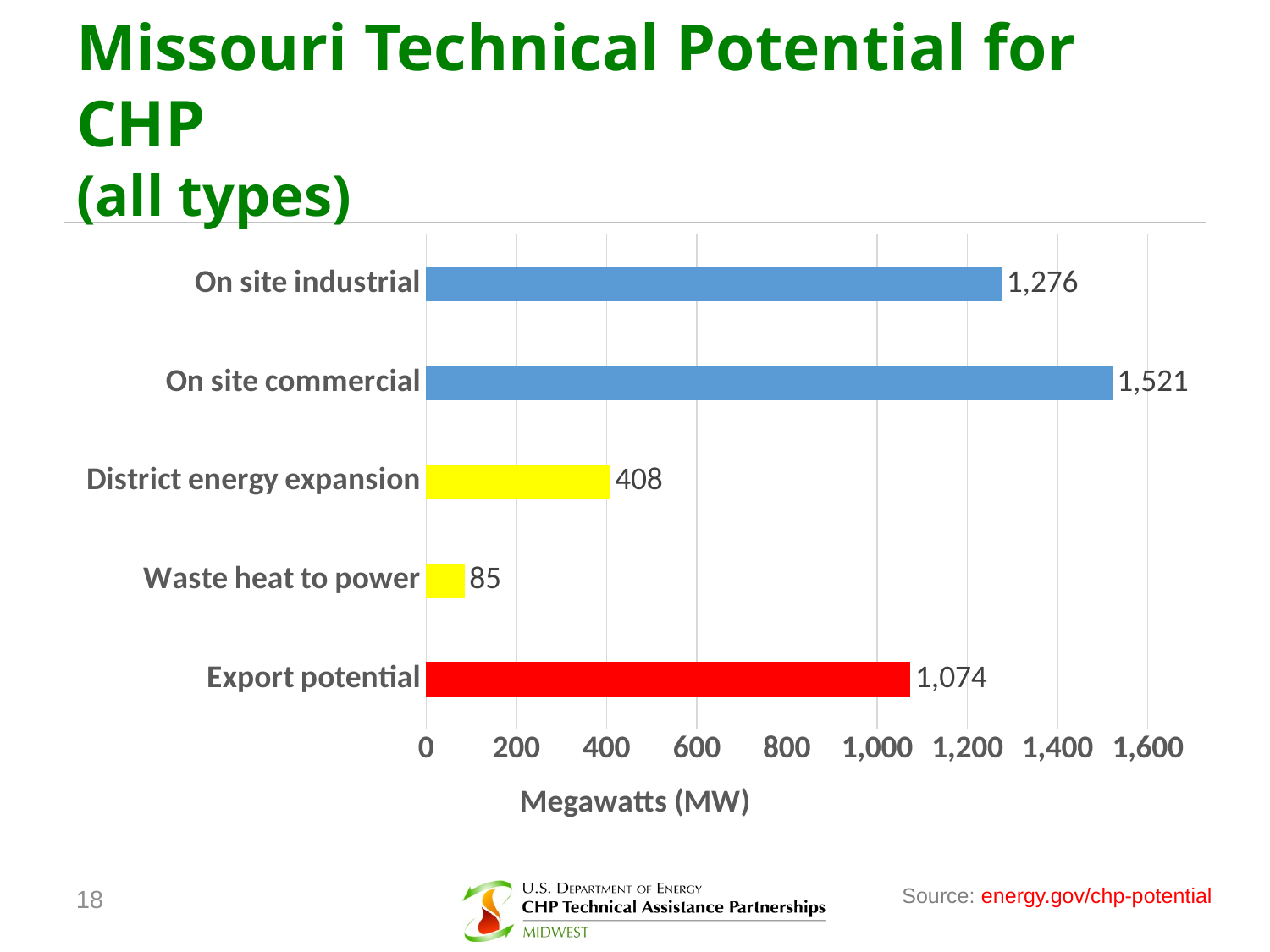
Which category has the highest value? On site commercial What is the value for Waste heat to power? 85 What is the label of the x axis? Megawatts (MW) Which is larger, Export potential or District energy expansion? Export potential Which category has the lowest value? Waste heat to power What is the value for Export potential? 1,074 What colour is the bar for Export potential? Red What is the value for On site industrial? 1,276 How many categories are shown in the chart? 5 What is the difference between District energy expansion and Waste heat to power? 323 What kind of chart is shown on the slide? Bar chart What is the difference between On site commercial and On site industrial? 245